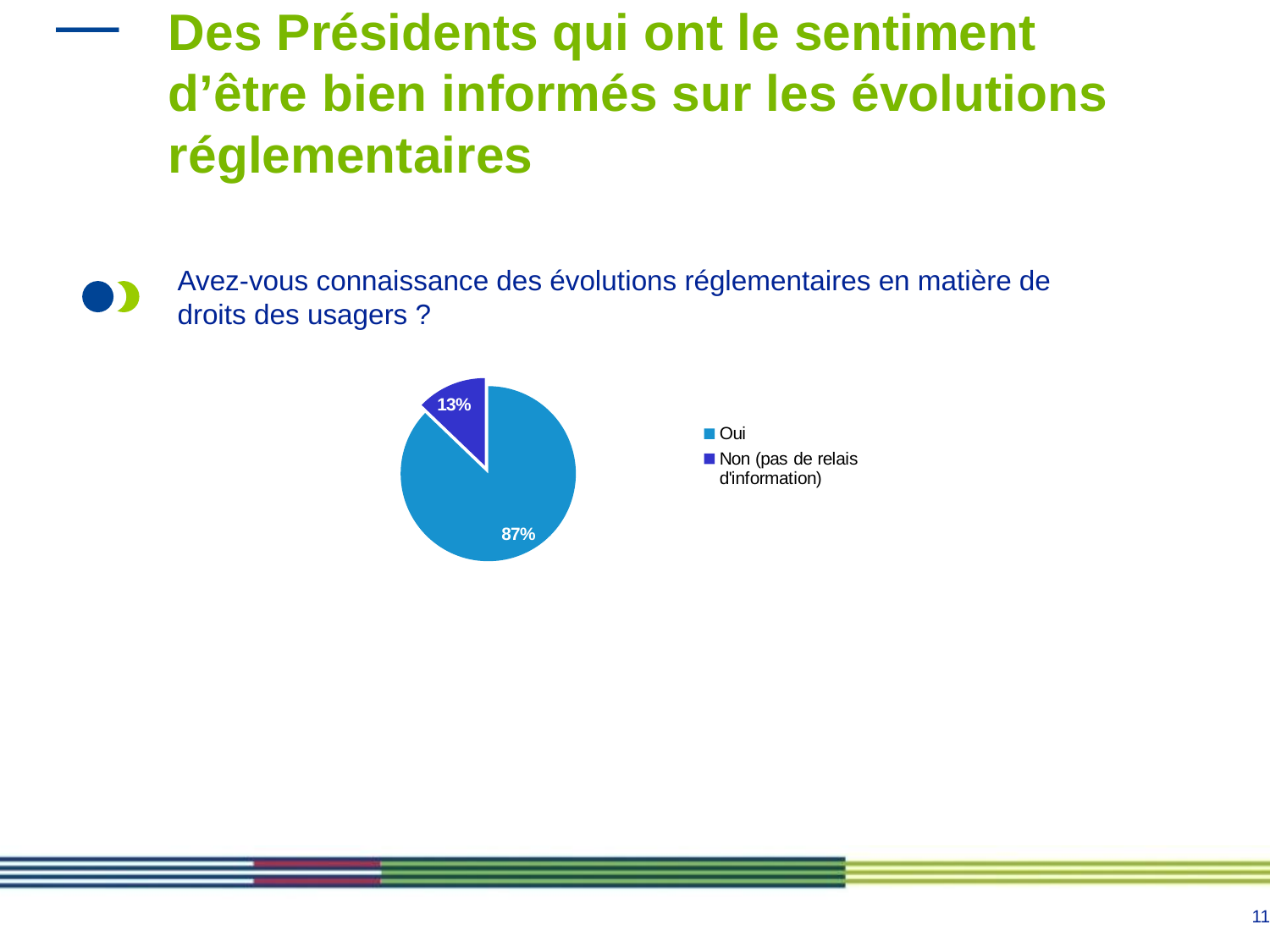
What share of the pie does the "Oui" slice represent? 87% What colour is the "Oui" slice in the pie chart? light blue What is the difference in percentage points between the "Oui" and "Non (pas de relais d'information)" slices? 74 Which is larger, the "Oui" slice or the "Non (pas de relais d'information)" slice? Oui How many slices does the pie chart have? 2 What kind of chart is shown on the slide? pie chart What percentage of respondents answered "Non (pas de relais d'information)"? 13% What percentage of respondents answered "Oui"? 87% How many entries does the legend list? 2 Which response has the smallest share of the pie? Non (pas de relais d'information) Which response has the largest share of the pie? Oui What question is the pie chart answering, as written above it? Avez-vous connaissance des évolutions réglementaires en matière de droits des usagers ?